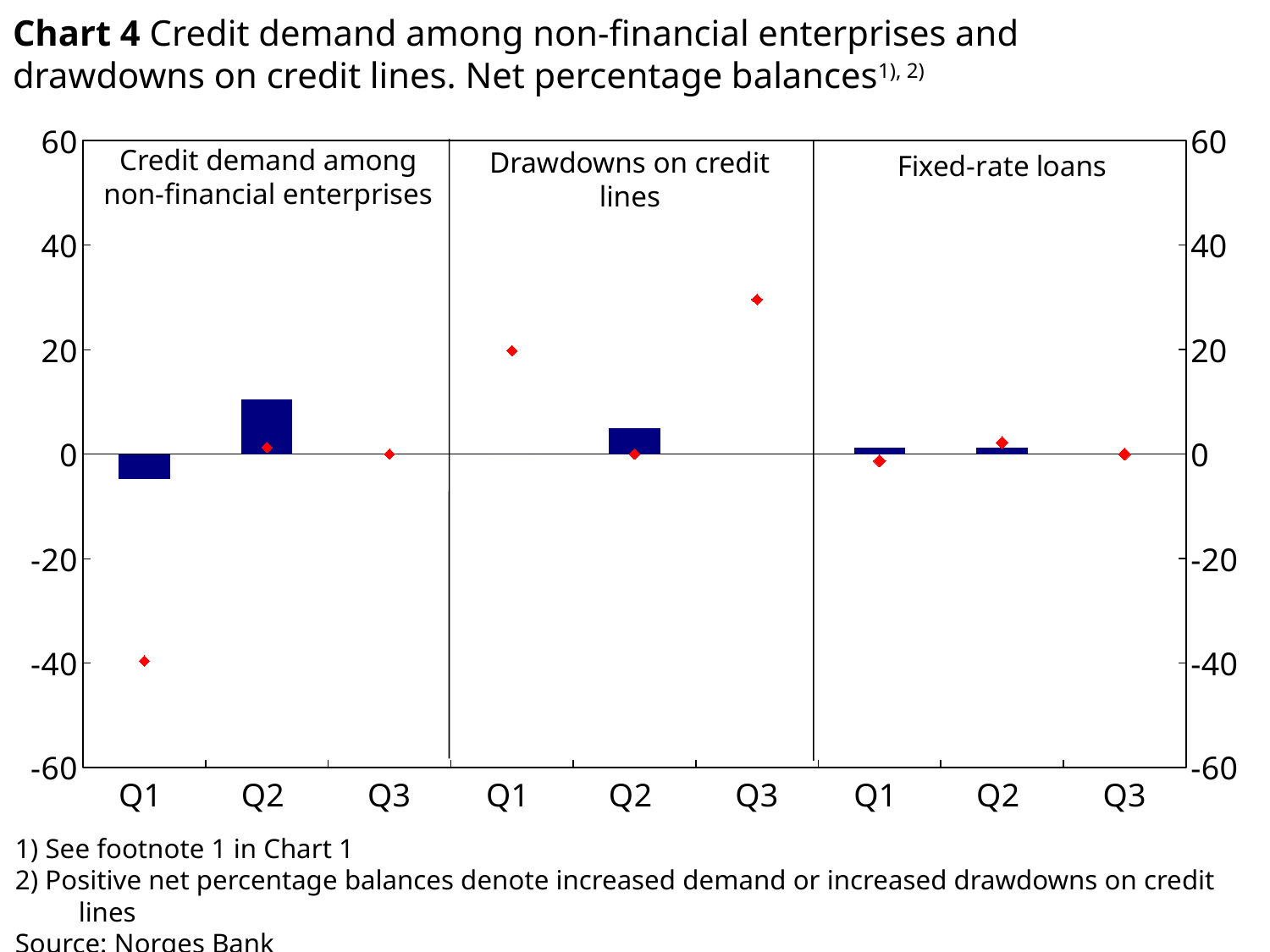
In the 'Credit demand among non-financial enterprises' panel, is the red marker for Q1 greater or less than -20? less In the 'Drawdowns on credit lines' panel, is the red marker for Q1 greater or less than 10? greater What kind of chart is Chart 4? combination bar and line chart (bars with red diamond markers) How many panels does Chart 4 have? 3 In the 'Drawdowns on credit lines' panel, which quarter has the highest red marker? Q3 Which is larger: the Q2 bar in the 'Credit demand among non-financial enterprises' panel or the Q2 bar in the 'Drawdowns on credit lines' panel? Credit demand among non-financial enterprises What is the title of the third panel in Chart 4? Fixed-rate loans In the 'Credit demand among non-financial enterprises' panel, is the bar for Q2 greater or less than 20? less In the 'Credit demand among non-financial enterprises' panel, which quarter has the lowest red marker? Q1 What is the source given for Chart 4? Norges Bank How many quarters are shown in each panel of Chart 4? 3